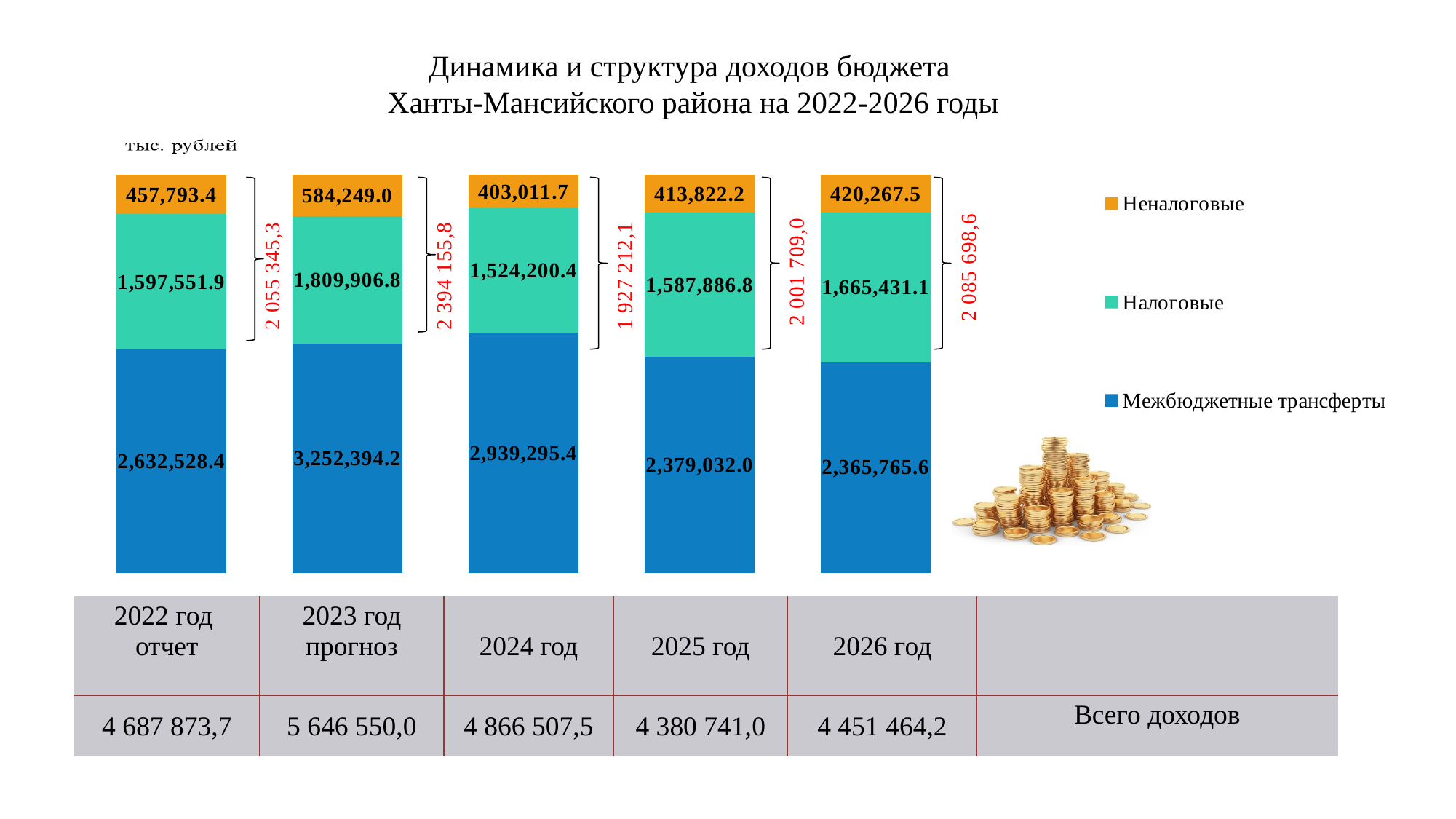
What is the value of Межбюджетные трансферты for 2025 год? 2,379,032.0 What is the difference between the Налоговые values for 2023 and 2022? 212,354.9 What is the value of Неналоговые for 2023 год прогноз? 584,249.0 Do the Межбюджетные трансферты values rise or fall from 2023 to 2026? Fall How many series does the legend list? 3 In which year is the Межбюджетные трансферты value the highest? 2023 год прогноз What is the value of Налоговые for 2024 год? 1,524,200.4 How many years (categories) are shown in the chart? 5 Which year has the larger Межбюджетные трансферты value, 2024 or 2025? 2024 год What kind of chart is shown on the slide? Stacked bar chart What is the total of the stacked bar for 2022 год отчет? 4 687 873,7 In which year is the Неналоговые value the lowest? 2024 год